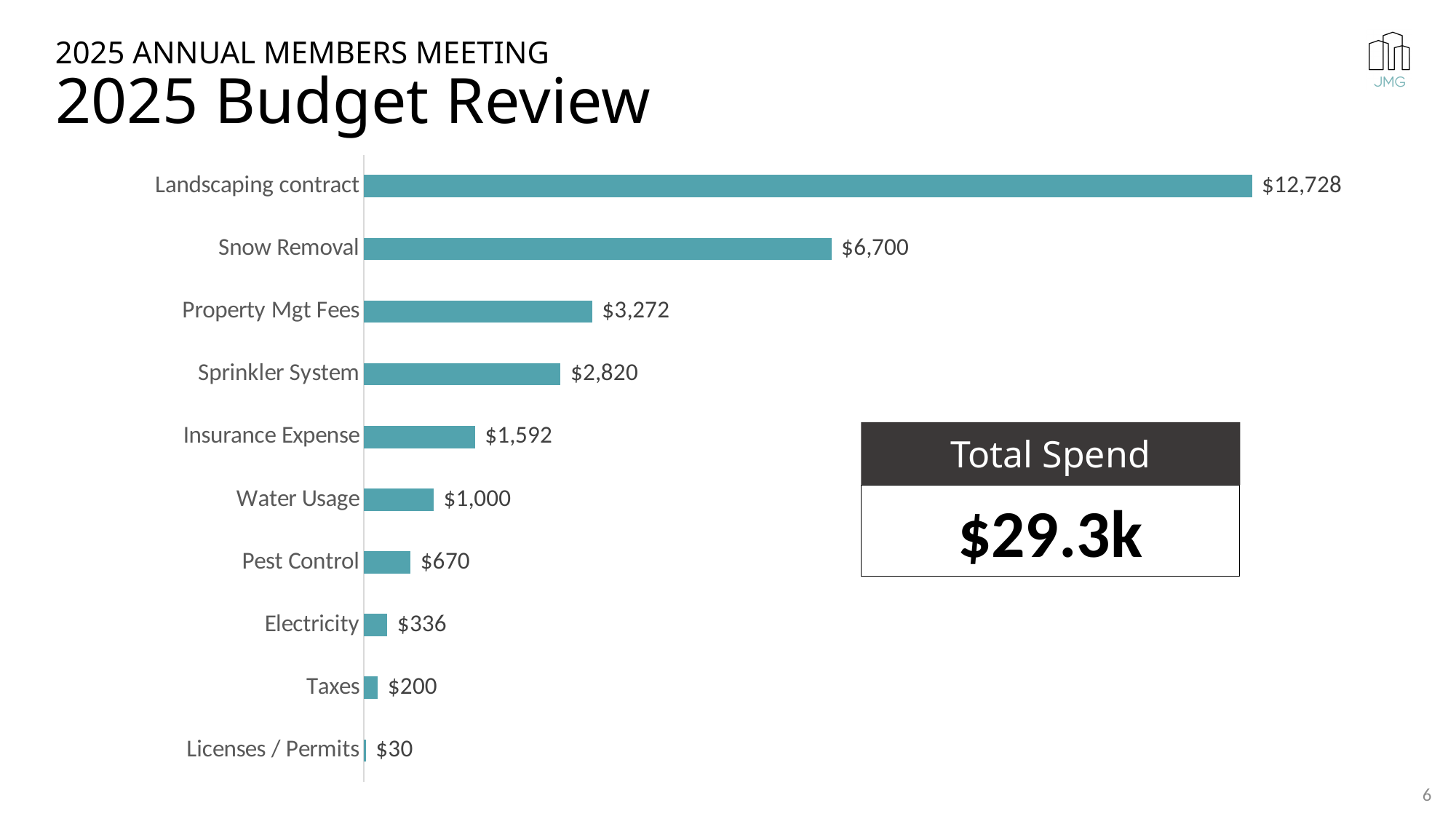
How many categories are shown in the chart? 10 What is the value for Landscaping contract? $12,728 What total spend is shown in the box next to the chart? $29.3k What is the value for Insurance Expense? $1,592 What is the value for Snow Removal? $6,700 Which category has the highest value? Landscaping contract Which is larger, Pest Control or Electricity? Pest Control Which category has the lowest value? Licenses / Permits What is the difference between Property Mgt Fees and Sprinkler System? $452 What is the value for Licenses / Permits? $30 What is the difference between Landscaping contract and Snow Removal? $6,028 What kind of chart is shown on the slide? Bar chart